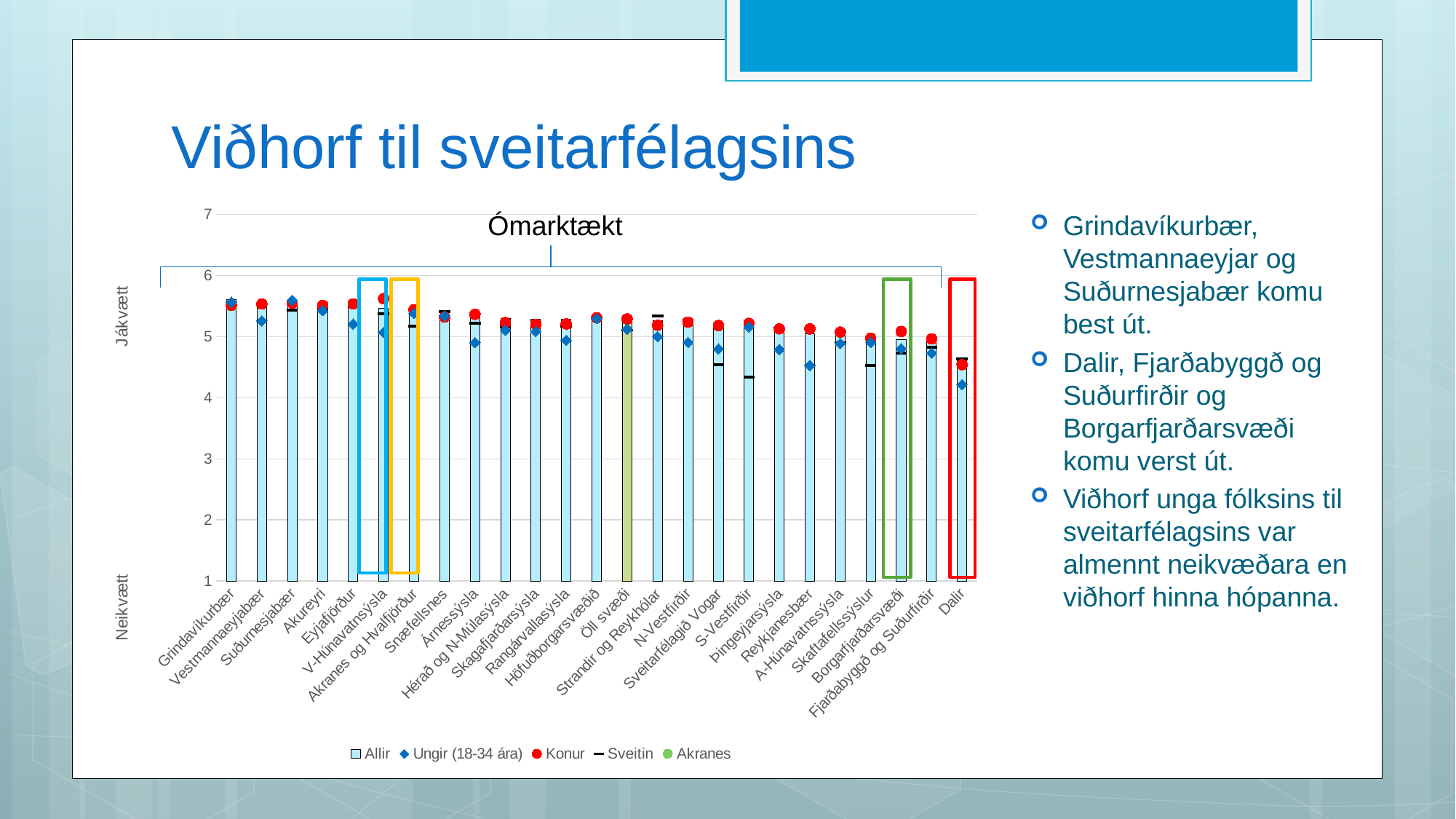
Is the Allir value for Grindavíkurbær greater or less than 5? greater What is the title of the slide containing the chart? Viðhorf til sveitarfélagsins How many series does the legend list? 5 Which category has the lowest Allir bar? Dalir Is the Allir value for Dalir greater or less than 5? less Do the Allir bars generally rise or fall from left to right along the x axis? fall Is the Sveitin value for S-Vestfirðir greater or less than 5? less How many categories (municipalities/regions) are shown on the x axis? 25 What word is written in the annotation above the bracket spanning most of the chart? Ómarktækt Which has the larger Allir value, Grindavíkurbær or Dalir? Grindavíkurbær What kind of chart is shown on the slide? bar chart